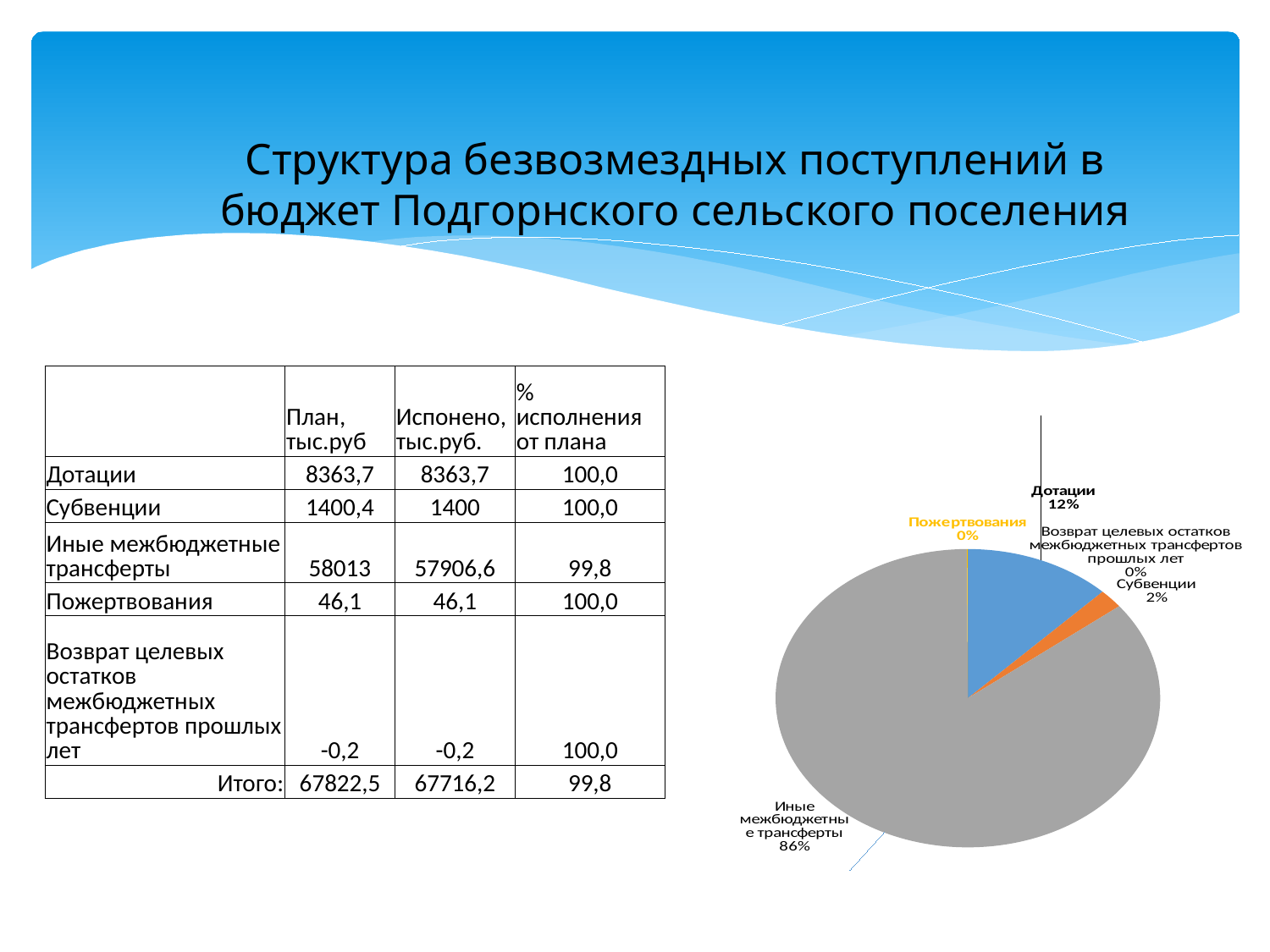
What is the difference in percentage points between the Дотации and Субвенции slices? 10 How many categories are labelled in the pie chart? 5 What colour is the Дотации slice in the pie chart? blue What share of the pie chart does Субвенции have? 2% What kind of chart is shown on the slide? pie chart What share of the pie chart does Пожертвования have? 0% Which category has the largest slice in the pie chart? Иные межбюджетные трансферты What colour is the Иные межбюджетные трансферты slice in the pie chart? grey What share of the pie chart does Дотации have? 12% Which slice is larger in the pie chart, Дотации or Субвенции? Дотации